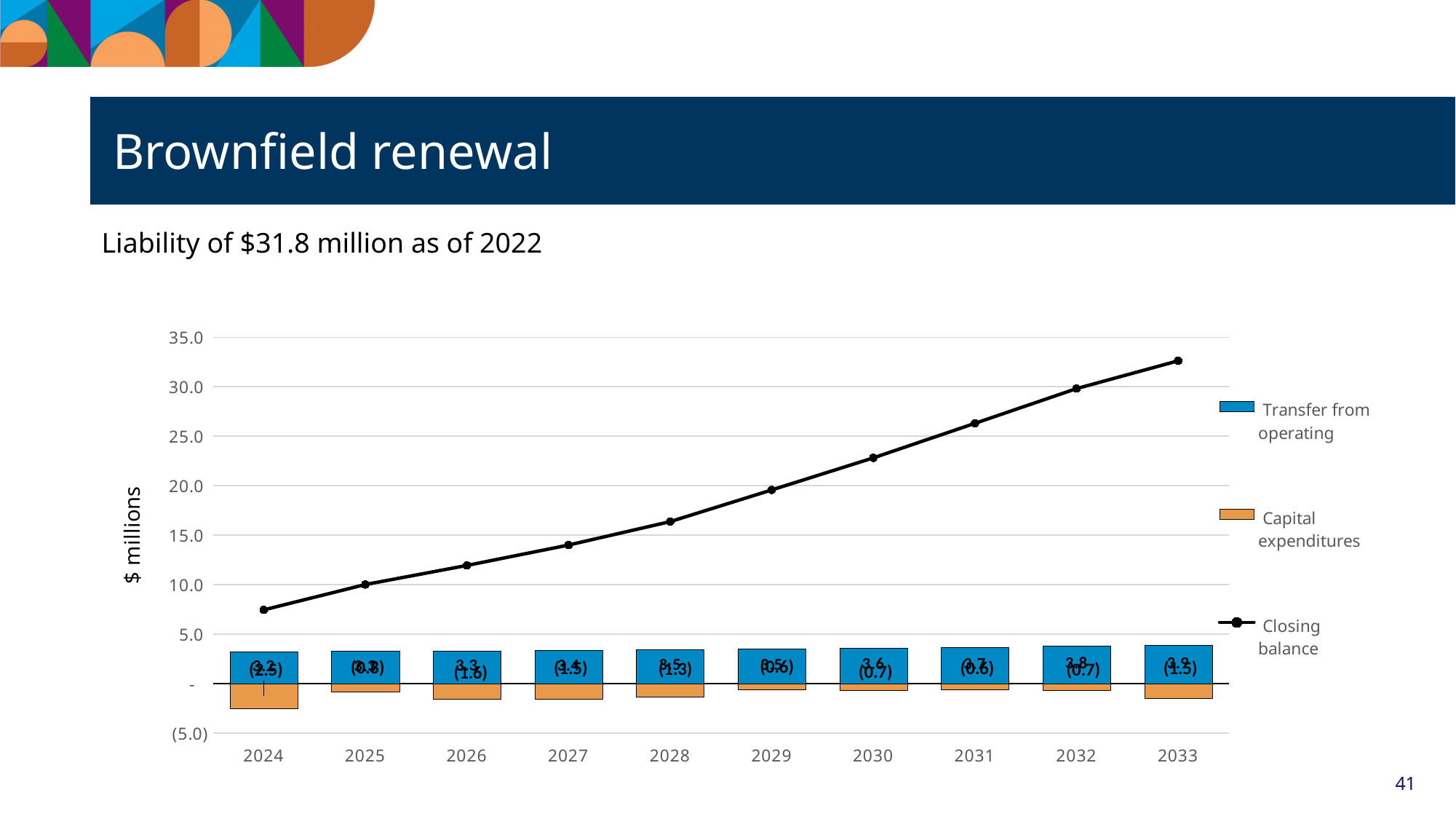
Is the Closing balance for 2031 greater or less than 25.0? greater What is the Capital expenditures value for 2026? (1.6) Which is larger, the Closing balance in 2027 or in 2025? 2027 Is the Closing balance for 2024 greater or less than 10.0? less Is the Closing balance for 2033 greater or less than 30.0? greater How many series does the legend list? 3 How many years are shown on the x axis? 10 In which year is the Closing balance lowest? 2024 In which year is the Closing balance highest? 2033 What is the y-axis label of the chart? $ millions What kind of chart is shown on the slide? A combined bar and line chart Does the Closing balance line rise or fall from 2024 to 2033? Rises